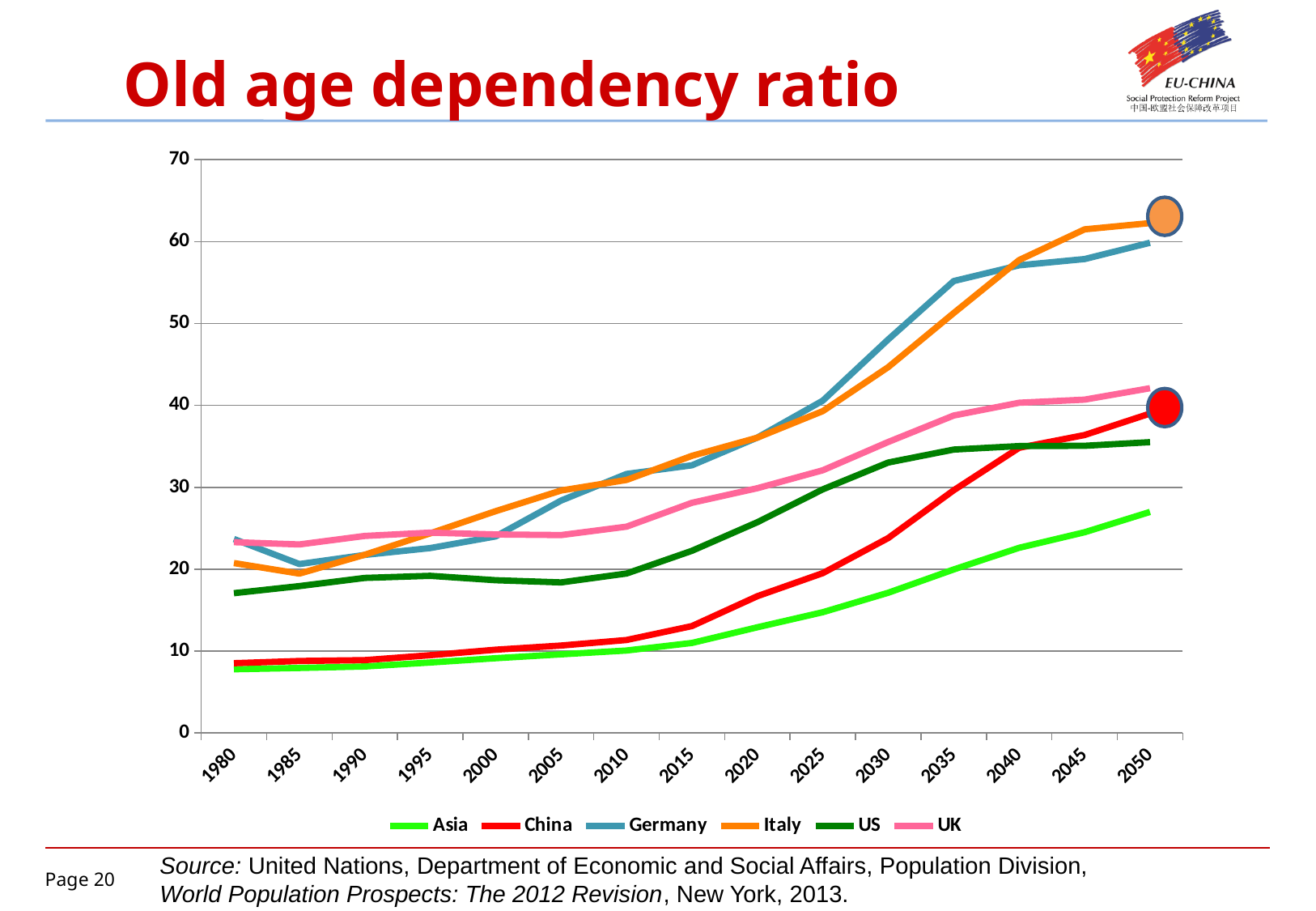
Which is larger in 2035, the value for Germany or the value for Italy? Germany Does the value for China rise or fall from 1980 to 2050? rise Which series has the highest value in 2050? Italy How many years are marked along the x axis? 15 How many series does the legend list? 6 Is the value for US in 1980 greater or less than 20? less Is the value for Italy in 2050 greater or less than 60? greater Which is larger in 2050, the value for UK or the value for US? UK Which series has the lowest value in 2050? Asia What kind of chart is shown on the slide? line chart Is the value for Asia in 2050 greater or less than 30? less What is the title of the chart? Old age dependency ratio